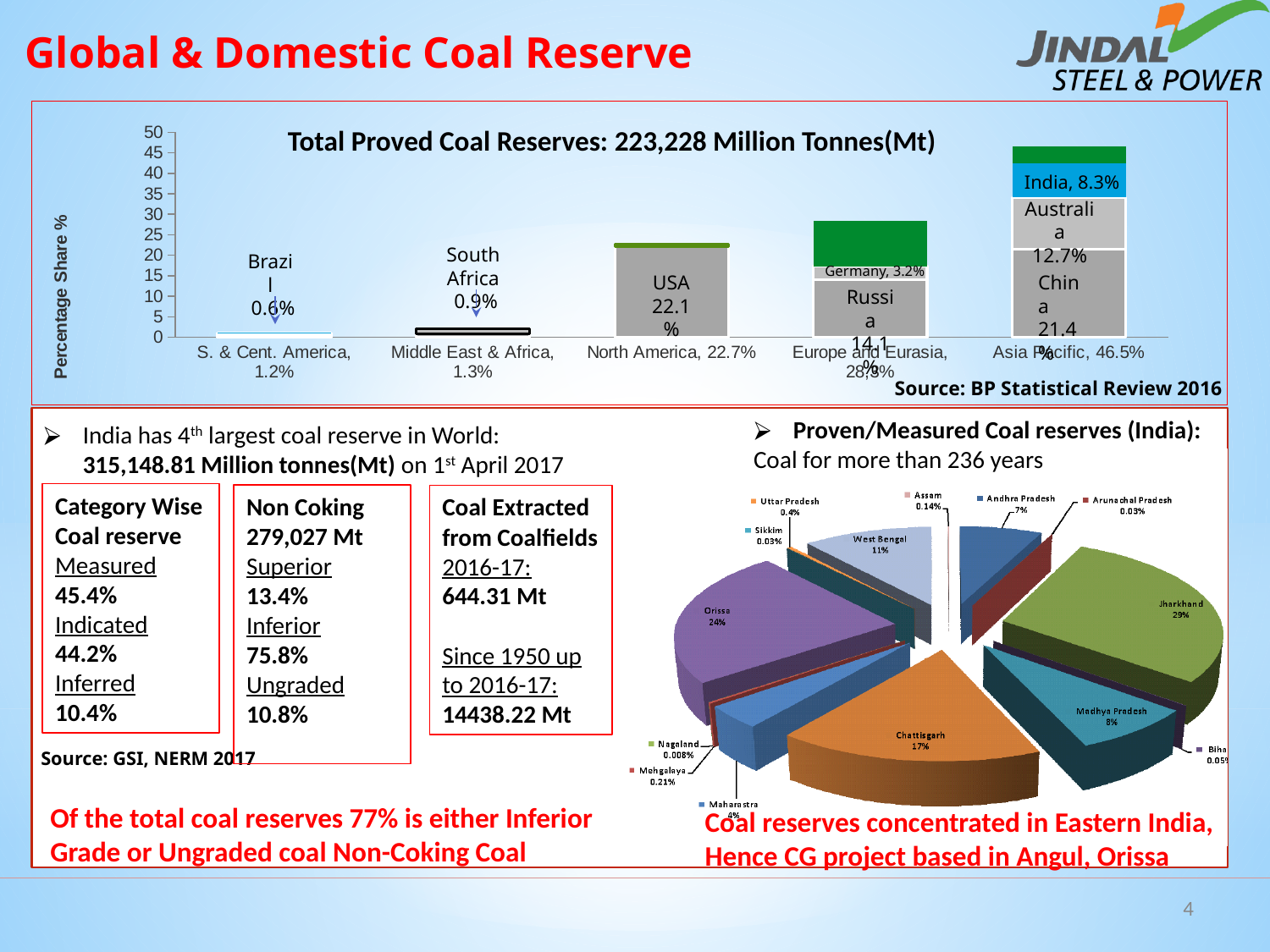
How many regions are shown on the x axis of the bar chart titled 'Total Proved Coal Reserves'? 5 In the bar chart titled 'Total Proved Coal Reserves', what is the percentage share for Asia Pacific? 46.5% In the bar chart titled 'Total Proved Coal Reserves', what share is labelled for India within the Asia Pacific bar? 8.3% In the pie chart of Proven/Measured Coal reserves (India), what is the share for Chattisgarh? 17% In the pie chart of Proven/Measured Coal reserves (India), what is the share for Orissa? 24% In the bar chart titled 'Total Proved Coal Reserves', which region has the highest percentage share? Asia Pacific In the pie chart of Proven/Measured Coal reserves (India), which state has the largest share? Jharkhand In the bar chart titled 'Total Proved Coal Reserves', what is the difference between the shares of Asia Pacific and Europe and Eurasia? 18.2% In the bar chart titled 'Total Proved Coal Reserves', which region has the lowest percentage share? S. & Cent. America In the bar chart titled 'Total Proved Coal Reserves', what is the percentage share for North America? 22.7% What type of chart is used for 'Total Proved Coal Reserves'? Bar chart In the bar chart titled 'Total Proved Coal Reserves', which is larger: the share labelled for USA or the share labelled for China? USA